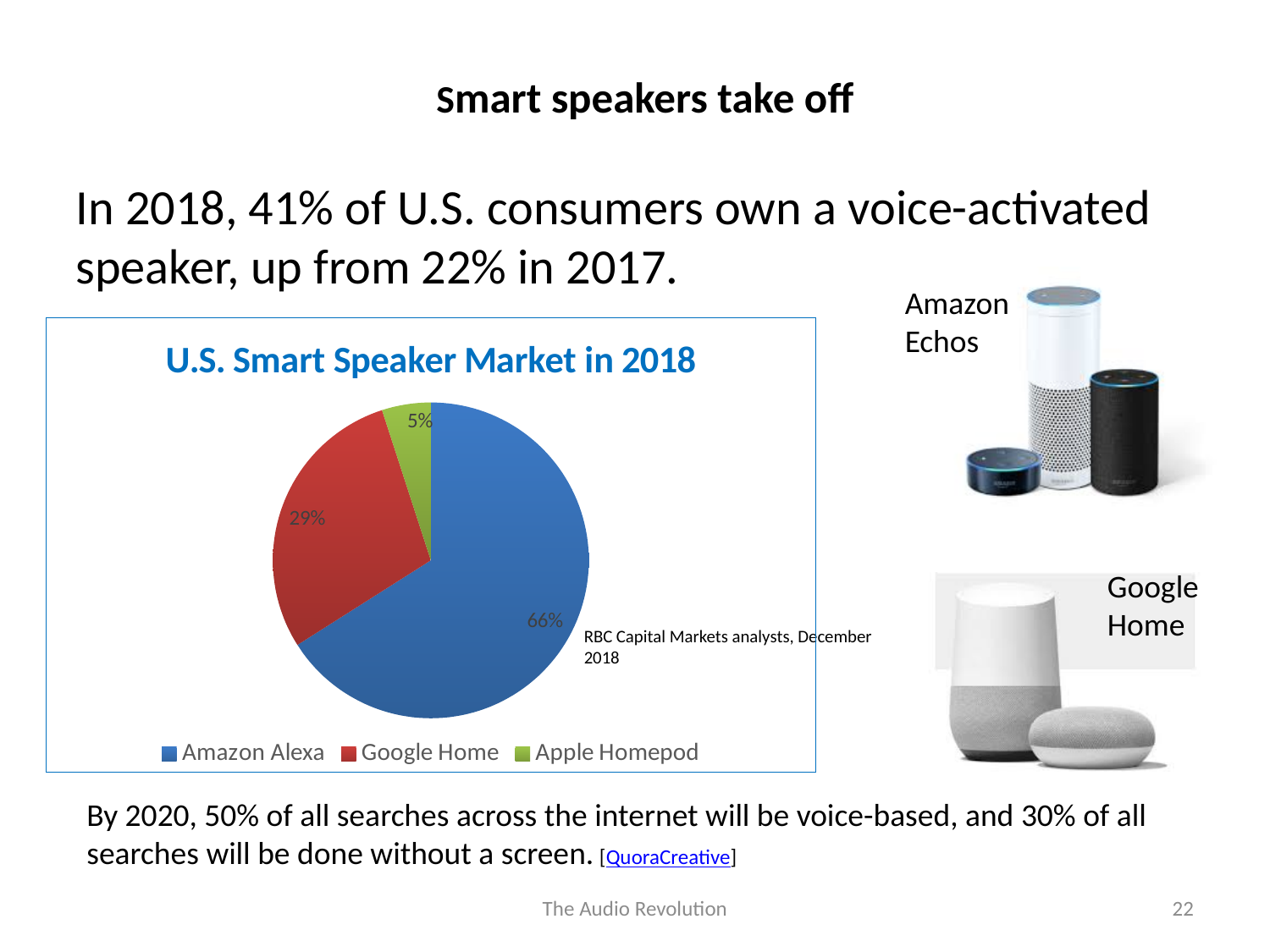
What is the difference in market share between Amazon Alexa and Google Home? 37% What is the difference in market share between Google Home and Apple Homepod? 24% What type of chart is shown on the slide? pie chart What is the title of the chart? U.S. Smart Speaker Market in 2018 Which colour represents Google Home in the pie chart? red What share of the U.S. smart speaker market in 2018 does Google Home hold? 29% What share of the U.S. smart speaker market in 2018 does Apple Homepod hold? 5% Which category has the largest slice of the pie? Amazon Alexa Which has a larger market share, Google Home or Apple Homepod? Google Home How many categories does the pie chart show? 3 Which category has the smallest slice of the pie? Apple Homepod What share of the U.S. smart speaker market in 2018 does Amazon Alexa hold? 66%